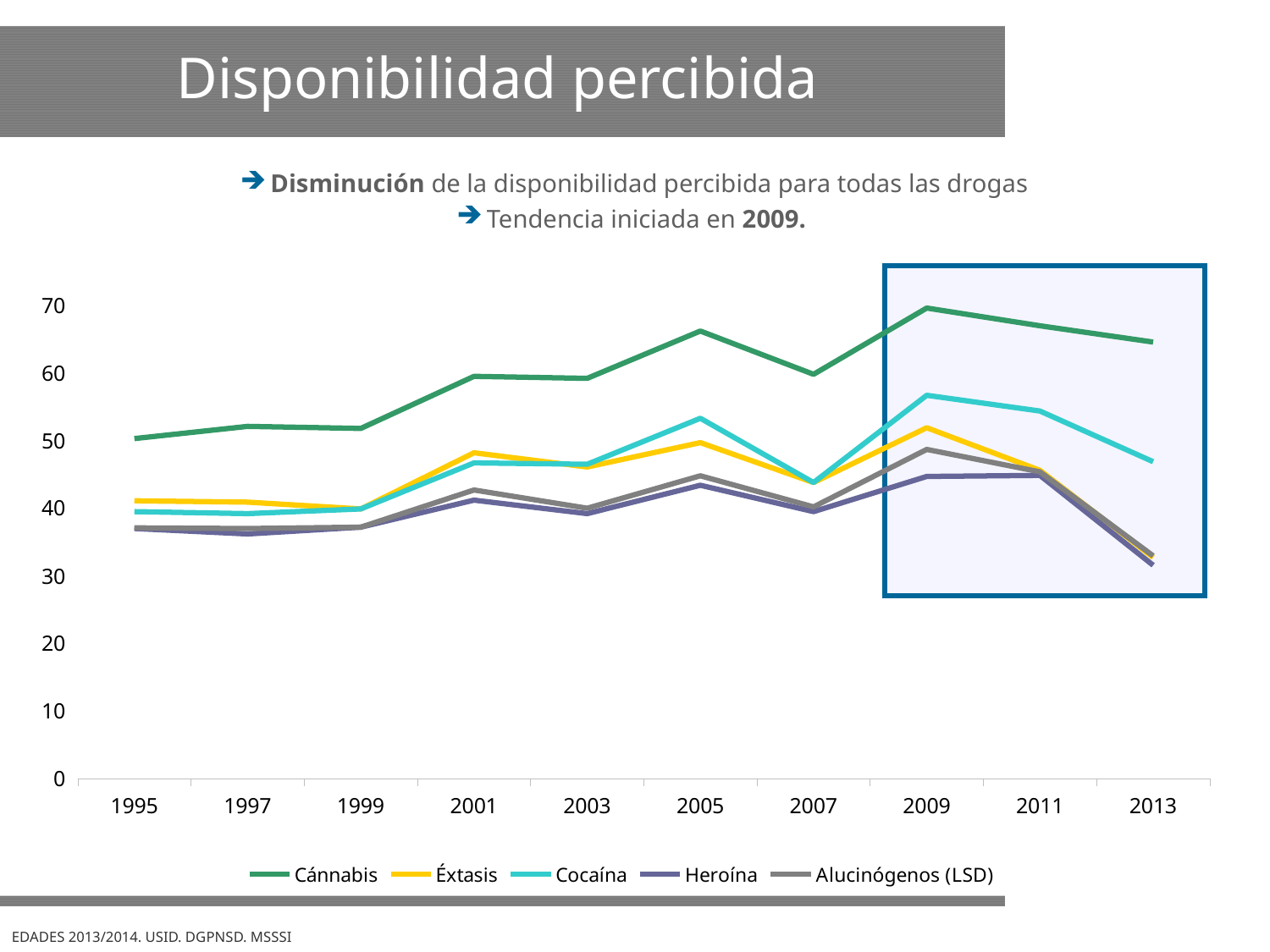
Which series has the highest value in 2013? Cánnabis In 2009, which is larger: the value for Cocaína or the value for Éxtasis? Cocaína Is the value for Heroína in 1995 greater or less than 40? less Which series has the lowest value in 2009? Heroína Is the value for Cánnabis in 2009 greater or less than 60? greater Is the value for Éxtasis in 2005 greater or less than 40? greater Which series are listed in the legend? Cánnabis, Éxtasis, Cocaína, Heroína, Alucinógenos (LSD) Does the Cánnabis line rise or fall from 2009 to 2013? fall How many series does the legend list? 5 What kind of chart is shown on the slide? line chart How many years are shown on the x axis? 10